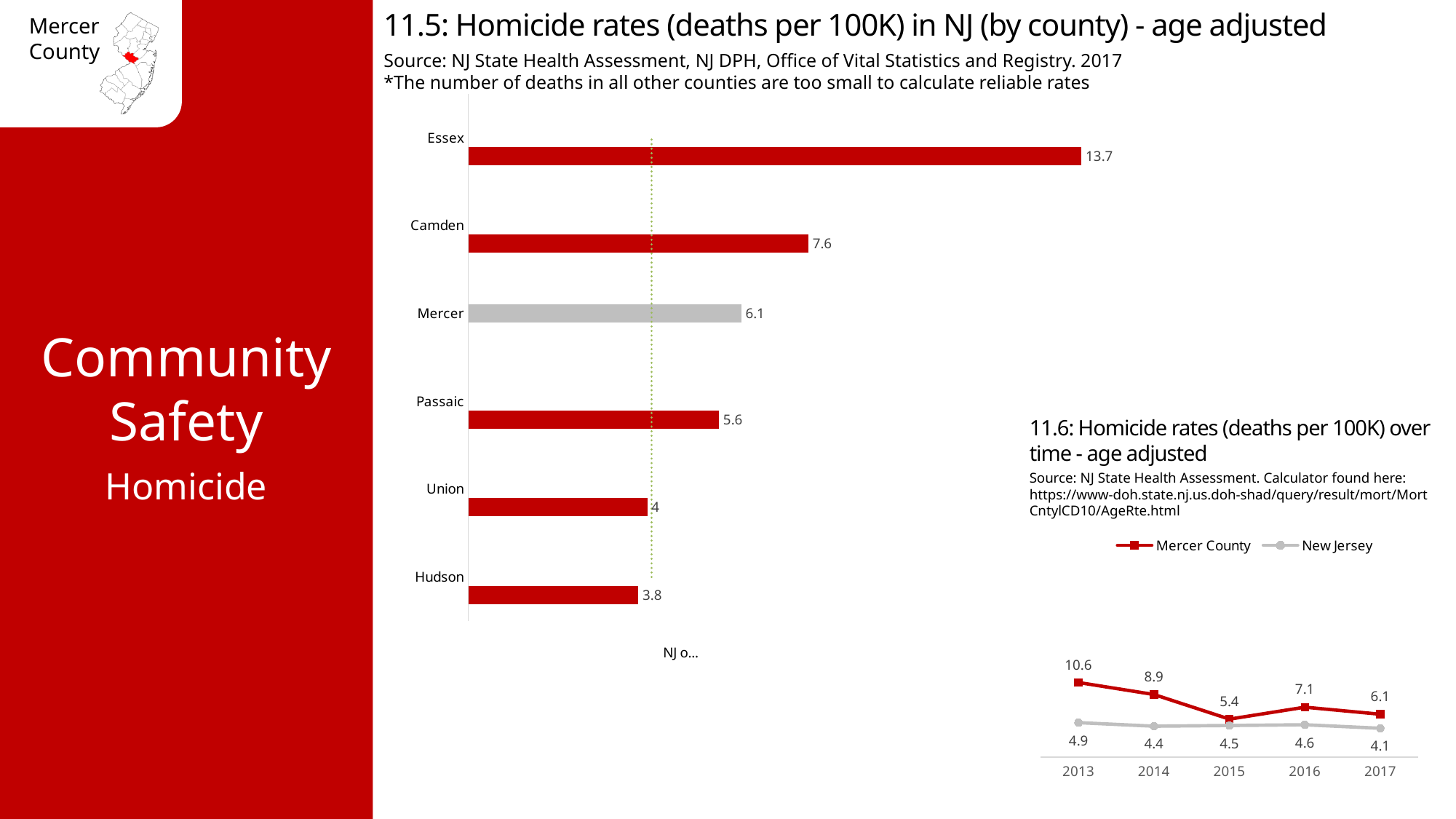
In the chart '11.6: Homicide rates (deaths per 100K) over time - age adjusted', what was the Mercer County rate in 2013? 10.6 In the chart '11.6: Homicide rates (deaths per 100K) over time - age adjusted', how many series does the legend list? 2 In the chart '11.5: Homicide rates (deaths per 100K) in NJ (by county) - age adjusted', which county has the highest homicide rate? Essex In the chart '11.5: Homicide rates (deaths per 100K) in NJ (by county) - age adjusted', what is the homicide rate for Mercer? 6.1 In the chart '11.5: Homicide rates (deaths per 100K) in NJ (by county) - age adjusted', what is the difference between the rates for Camden and Passaic? 2 What kind of chart is '11.5: Homicide rates (deaths per 100K) in NJ (by county) - age adjusted'? Bar chart In the chart '11.5: Homicide rates (deaths per 100K) in NJ (by county) - age adjusted', what is the homicide rate for Essex? 13.7 In the chart '11.6: Homicide rates (deaths per 100K) over time - age adjusted', what is the difference between the Mercer County and New Jersey rates in 2015? 0.9 In the chart '11.6: Homicide rates (deaths per 100K) over time - age adjusted', which is larger in 2016: Mercer County or New Jersey? Mercer County In the chart '11.6: Homicide rates (deaths per 100K) over time - age adjusted', what was the New Jersey rate in 2017? 4.1 In the chart '11.5: Homicide rates (deaths per 100K) in NJ (by county) - age adjusted', which county has the lowest homicide rate? Hudson In the chart '11.5: Homicide rates (deaths per 100K) in NJ (by county) - age adjusted', how many counties are shown? 6